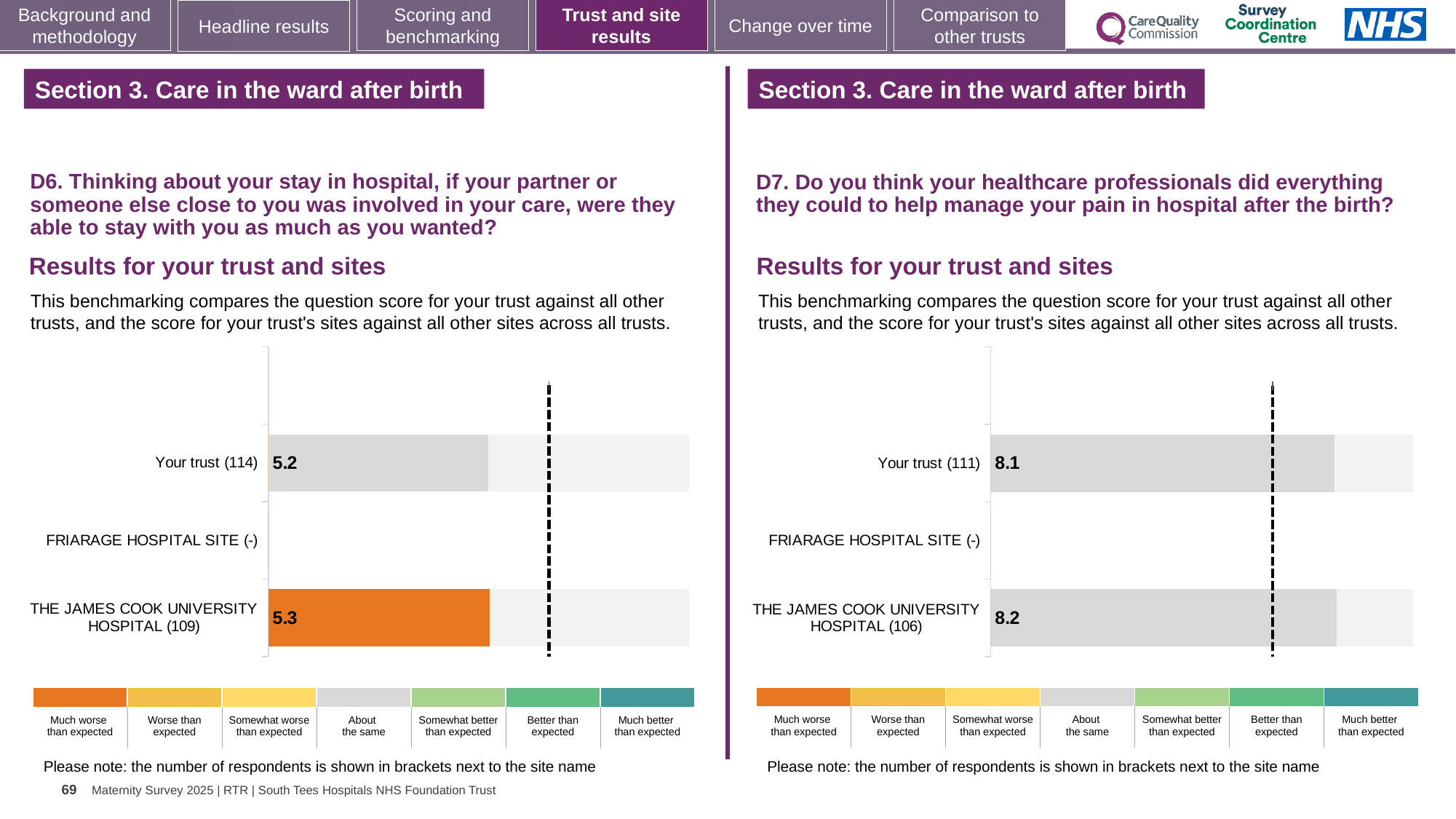
On the right chart (D7), what is the difference between the score for THE JAMES COOK UNIVERSITY HOSPITAL and the score for Your trust? 0.1 On the right chart (D7), what is the score for THE JAMES COOK UNIVERSITY HOSPITAL (106)? 8.2 On the left chart (D6), which has the higher score: Your trust or THE JAMES COOK UNIVERSITY HOSPITAL? THE JAMES COOK UNIVERSITY HOSPITAL On the left chart (D6), which site has no bar plotted? FRIARAGE HOSPITAL SITE (-) How many categories are listed on the left chart (D6)? 3 On the left chart (D6), what is the difference between the score for THE JAMES COOK UNIVERSITY HOSPITAL and the score for Your trust? 0.1 On the left chart (D6), what is the score for Your trust (114)? 5.2 On the right chart (D7), which has the higher score: Your trust or THE JAMES COOK UNIVERSITY HOSPITAL? THE JAMES COOK UNIVERSITY HOSPITAL On the right chart (D7), what is the score for Your trust (111)? 8.1 On the left chart (D6), what is the score for THE JAMES COOK UNIVERSITY HOSPITAL (109)? 5.3 What kind of chart is used on the right side of the slide (D7)? Bar chart On the left chart (D6), what colour is the bar for THE JAMES COOK UNIVERSITY HOSPITAL (109)? Orange